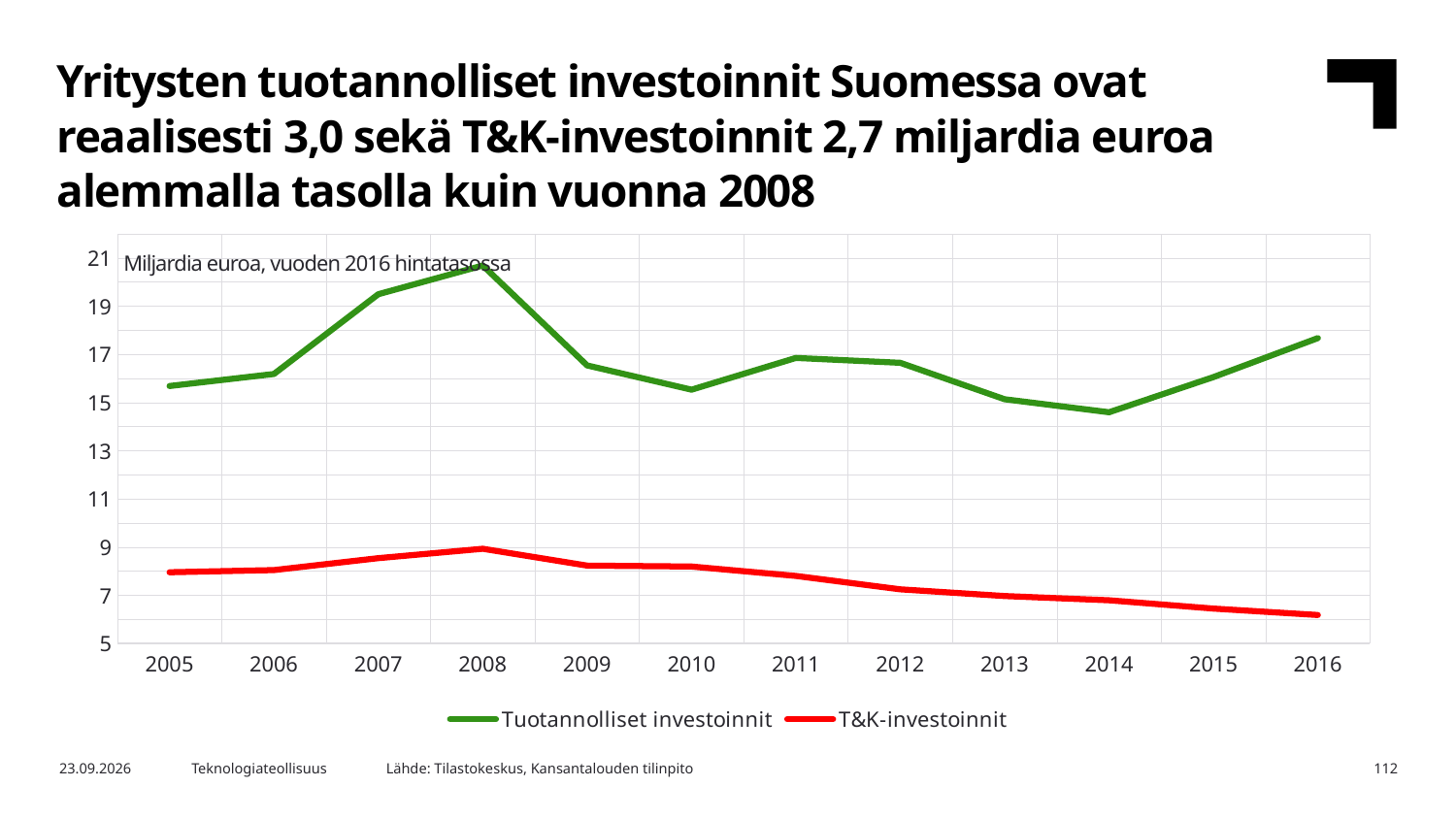
In which year is the value for Tuotannolliset investoinnit highest? 2008 In which year is the value for T&K-investoinnit lowest? 2016 Which is larger: the value for T&K-investoinnit in 2008 or in 2014? 2008 In which year is the value for Tuotannolliset investoinnit lowest? 2014 Is the value for T&K-investoinnit in 2016 greater or less than 7? less In which year is the value for T&K-investoinnit highest? 2008 Is the value for Tuotannolliset investoinnit in 2008 greater or less than 19? greater Do the values for T&K-investoinnit rise or fall from 2008 to 2016? fall How many years are shown on the x axis? 12 What kind of chart is shown on the slide? line chart How many series does the legend list? 2 Is the value for Tuotannolliset investoinnit in 2014 greater or less than 15? less